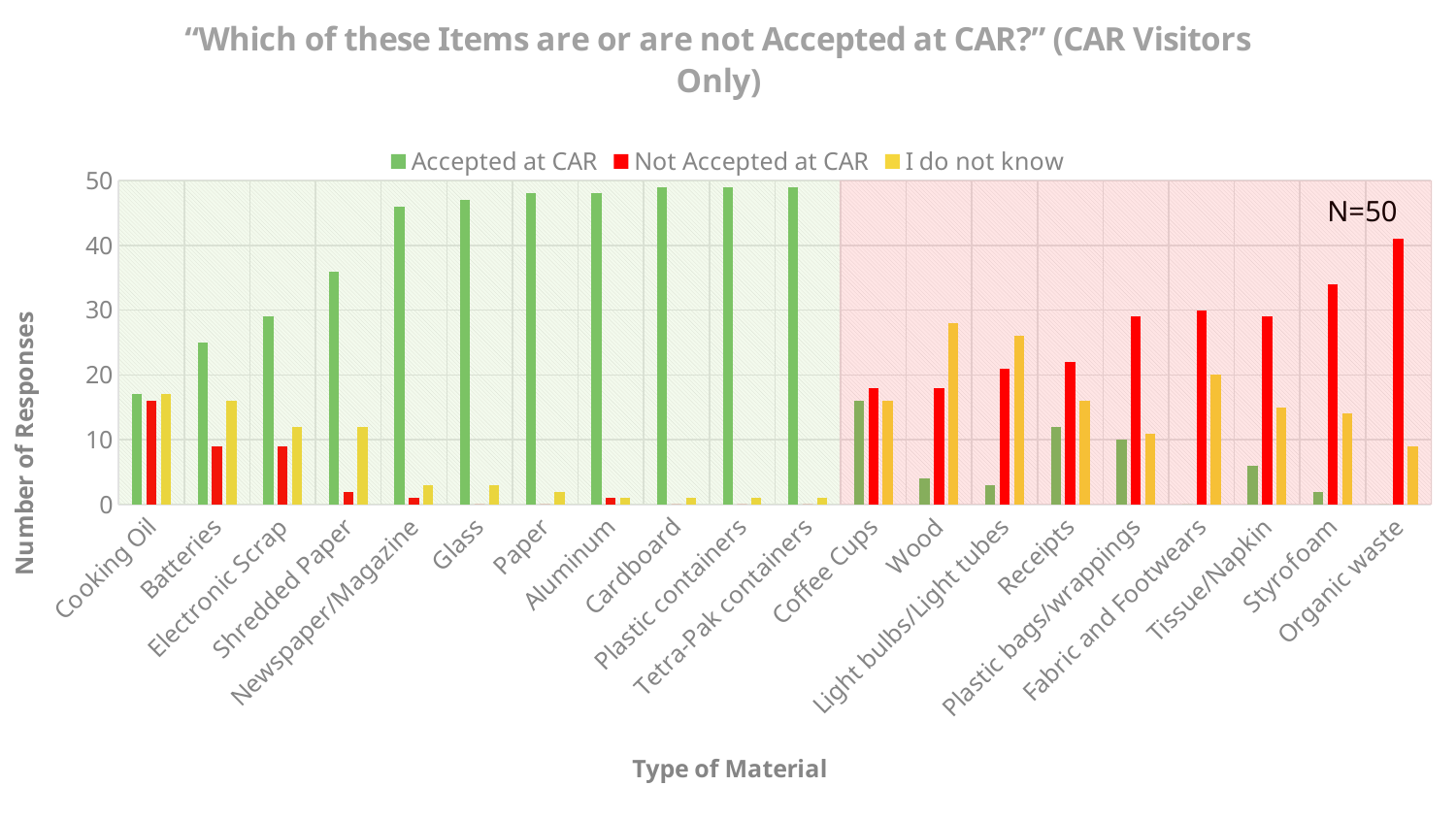
Which has a larger 'Accepted at CAR' value, Cardboard or Cooking Oil? Cardboard Which has a larger 'Not Accepted at CAR' value, Organic waste or Coffee Cups? Organic waste What is the label of the y axis? Number of Responses What kind of chart is shown on the slide? bar chart Is the 'Not Accepted at CAR' value for Styrofoam greater or less than 30? greater Which category has the highest value for the 'Not Accepted at CAR' series? Organic waste What sample size is annotated on the chart? N=50 Is the 'Accepted at CAR' value for Glass greater or less than 40? greater How many series does the legend list? 3 Is the 'Accepted at CAR' value for Batteries greater or less than 20? greater How many material categories are shown on the x axis? 20